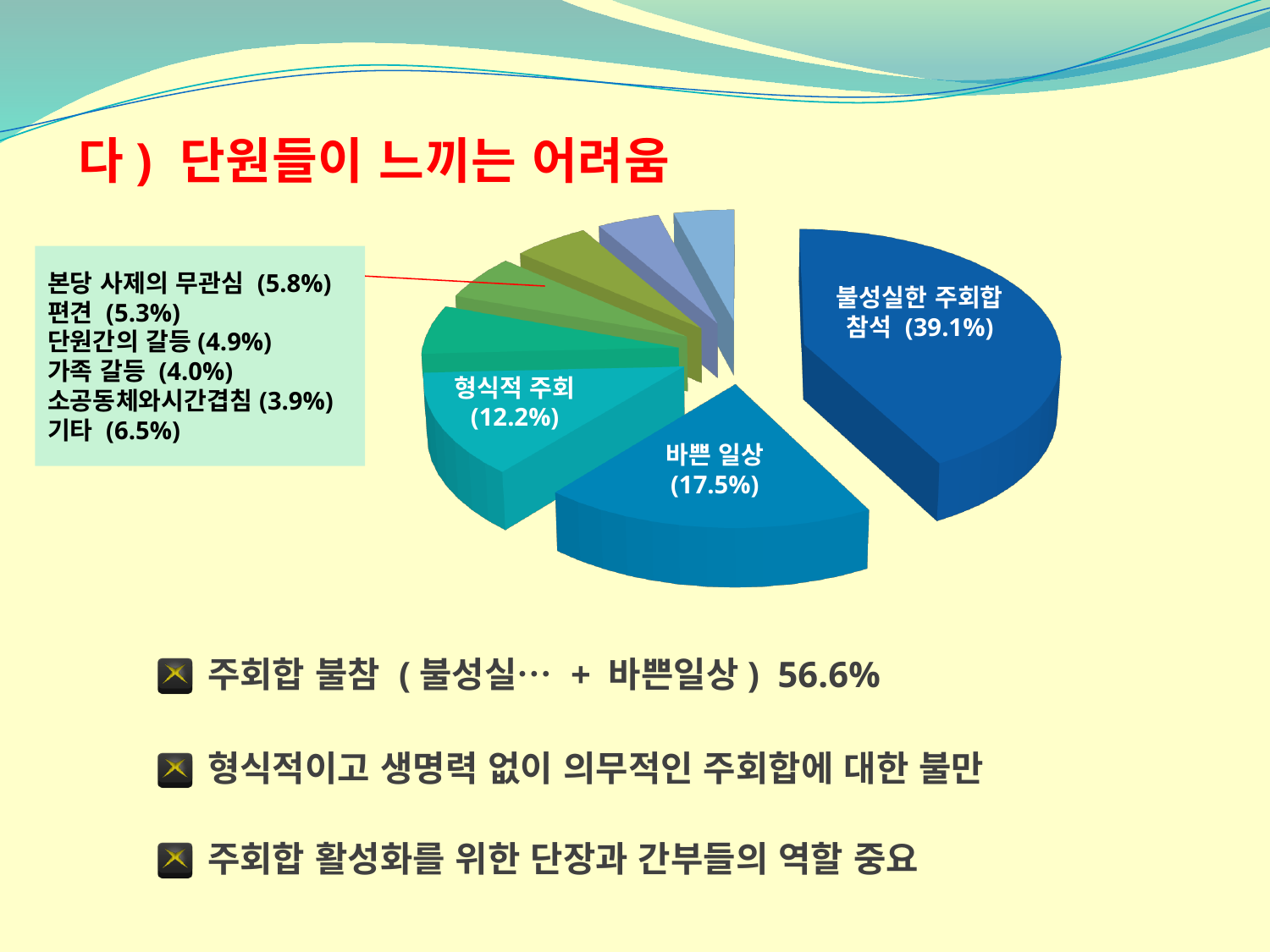
What is the combined share of 불성실한 주회합 참석 and 바쁜 일상? 56.6% What percentage is given for 본당 사제의 무관심? 5.8% What percentage does the pie chart show for 형식적 주회? 12.2% Which category has the largest share of the pie chart? 불성실한 주회합 참석 Which has the larger share, 편견 or 단원간의 갈등? 편견 What is the title of the slide above the chart? 다) 단원들이 느끼는 어려움 What is the difference in percentage points between 불성실한 주회합 참석 and 바쁜 일상? 21.6 What percentage is given for 기타? 6.5% What kind of chart is shown on the slide? Pie chart What percentage does the pie chart show for 불성실한 주회합 참석? 39.1% Which category has the smallest share of the pie chart? 소공동체와시간겹침 What percentage does the pie chart show for 바쁜 일상? 17.5%